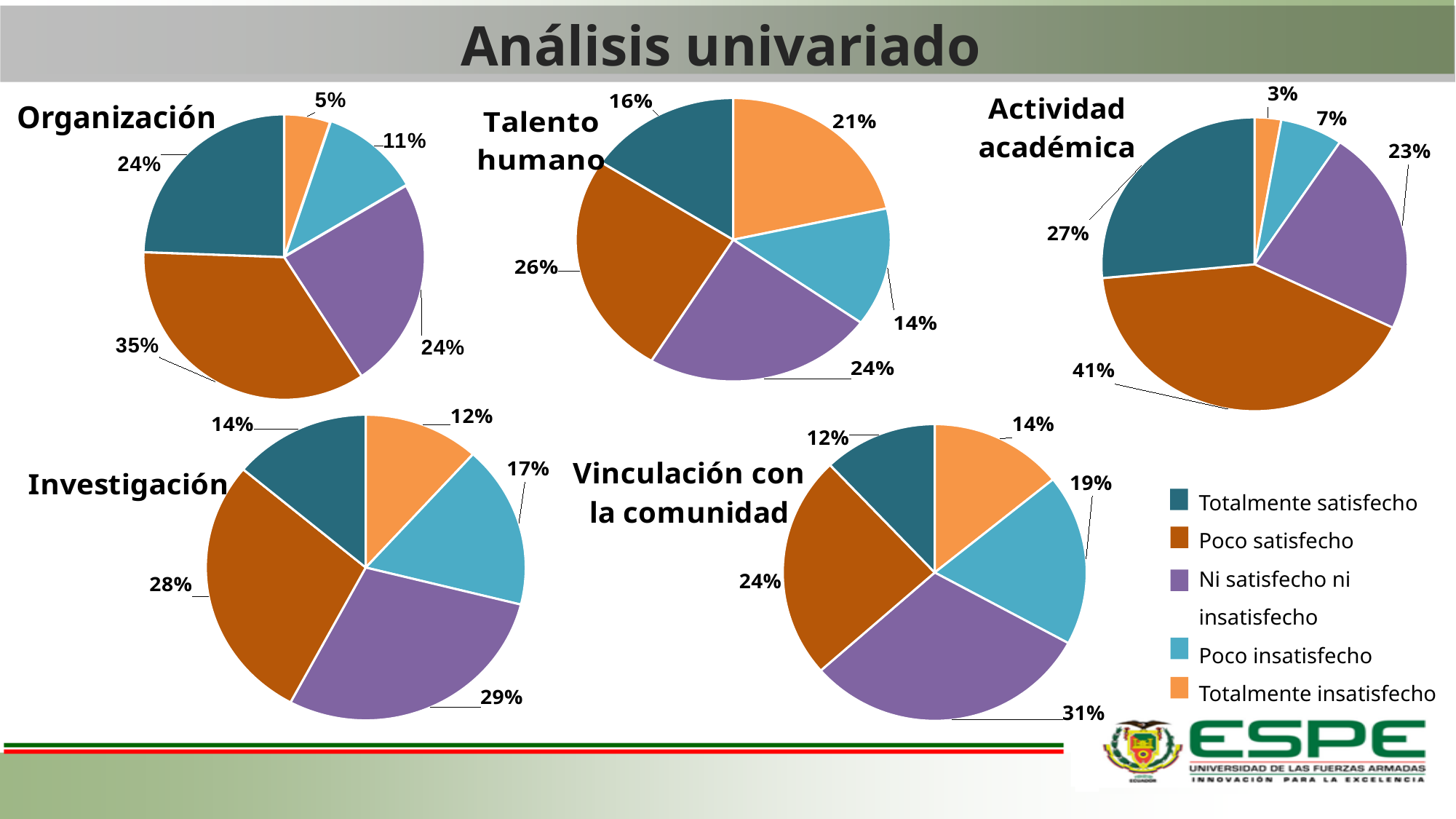
In the Actividad académica pie chart, which category has the largest share? Poco satisfecho In the Talento humano pie chart, which is larger: Poco satisfecho or Totalmente insatisfecho? Poco satisfecho In the Investigación pie chart, what share is Poco insatisfecho? 17% In the Actividad académica pie chart, which category has the smallest share? Totalmente insatisfecho What type of chart is used for Organización? Pie chart In the Organización pie chart, what share is Totalmente insatisfecho? 5% How many slices does the Investigación pie chart have? 5 In the Vinculación con la comunidad pie chart, what is the difference between Poco satisfecho and Totalmente satisfecho? 12% In the Organización pie chart, what share is Poco satisfecho? 35% In the Vinculación con la comunidad pie chart, what share is Ni satisfecho ni insatisfecho? 31% In the Talento humano pie chart, what share is Totalmente satisfecho? 16% How many entries does the legend list? 5